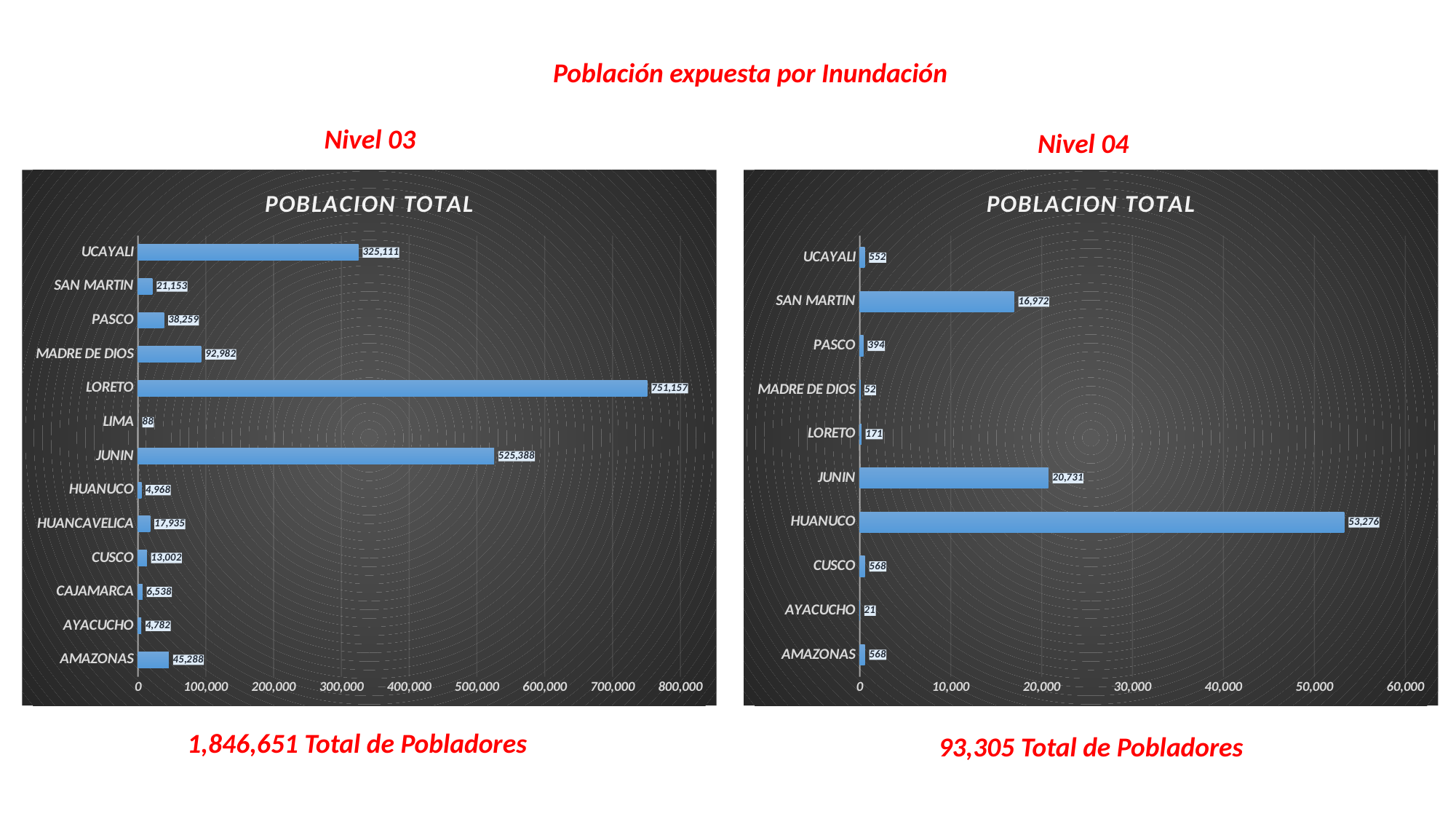
In the Nivel 03 chart, what is the value for LORETO? 751,157 In the Nivel 03 chart, how many categories are shown? 13 In the Nivel 04 chart, which is larger, JUNIN or SAN MARTIN? JUNIN In the Nivel 03 chart, which category has the lowest value? LIMA In the Nivel 04 chart, which category has the lowest value? AYACUCHO What kind of chart is the Nivel 04 chart? Bar chart In the Nivel 03 chart, is the value for UCAYALI greater or less than 300,000? greater In the Nivel 03 chart, what is the value for MADRE DE DIOS? 92,982 In the Nivel 04 chart, what is the value for SAN MARTIN? 16,972 In the Nivel 04 chart, what is the difference between HUANUCO and JUNIN? 32,545 In the Nivel 03 chart, what is the difference between LORETO and JUNIN? 225,769 In the Nivel 04 chart, which category has the highest value? HUANUCO